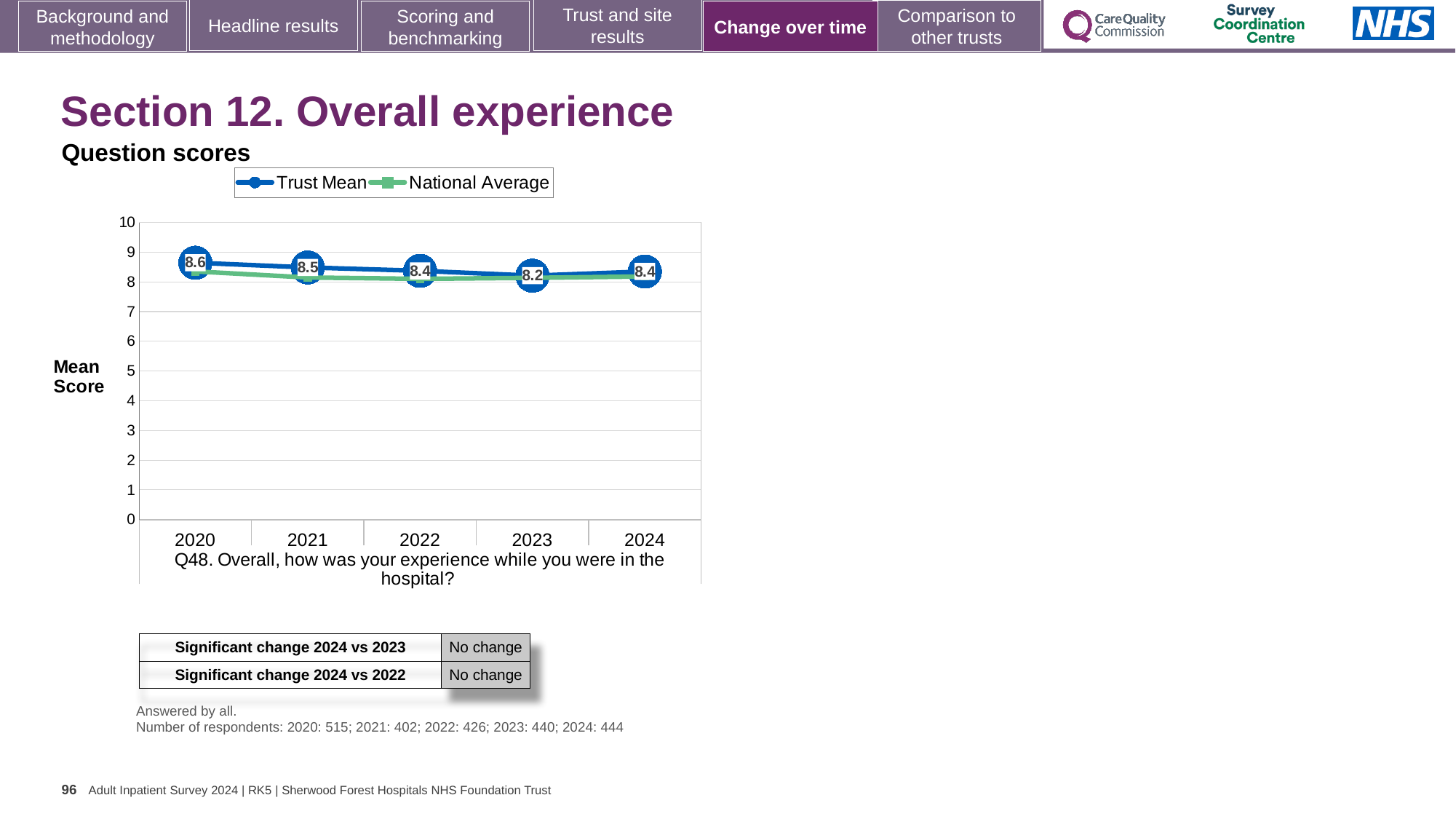
Which is larger, the Trust Mean score in 2021 or in 2024? 2021 What kind of chart is shown? Line chart What is the difference between the Trust Mean score in 2020 and in 2023? 0.4 In which year was the Trust Mean score highest? 2020 How many years are plotted on the x axis? 5 How many series does the legend list? 2 Did the Trust Mean score rise or fall from 2020 to 2023? Fall What is the Trust Mean score for 2023? 8.2 What is the Trust Mean score for 2024? 8.4 Is the National Average value for 2022 greater or less than 5? greater In which year was the Trust Mean score lowest? 2023 What is the Trust Mean score for 2020? 8.6